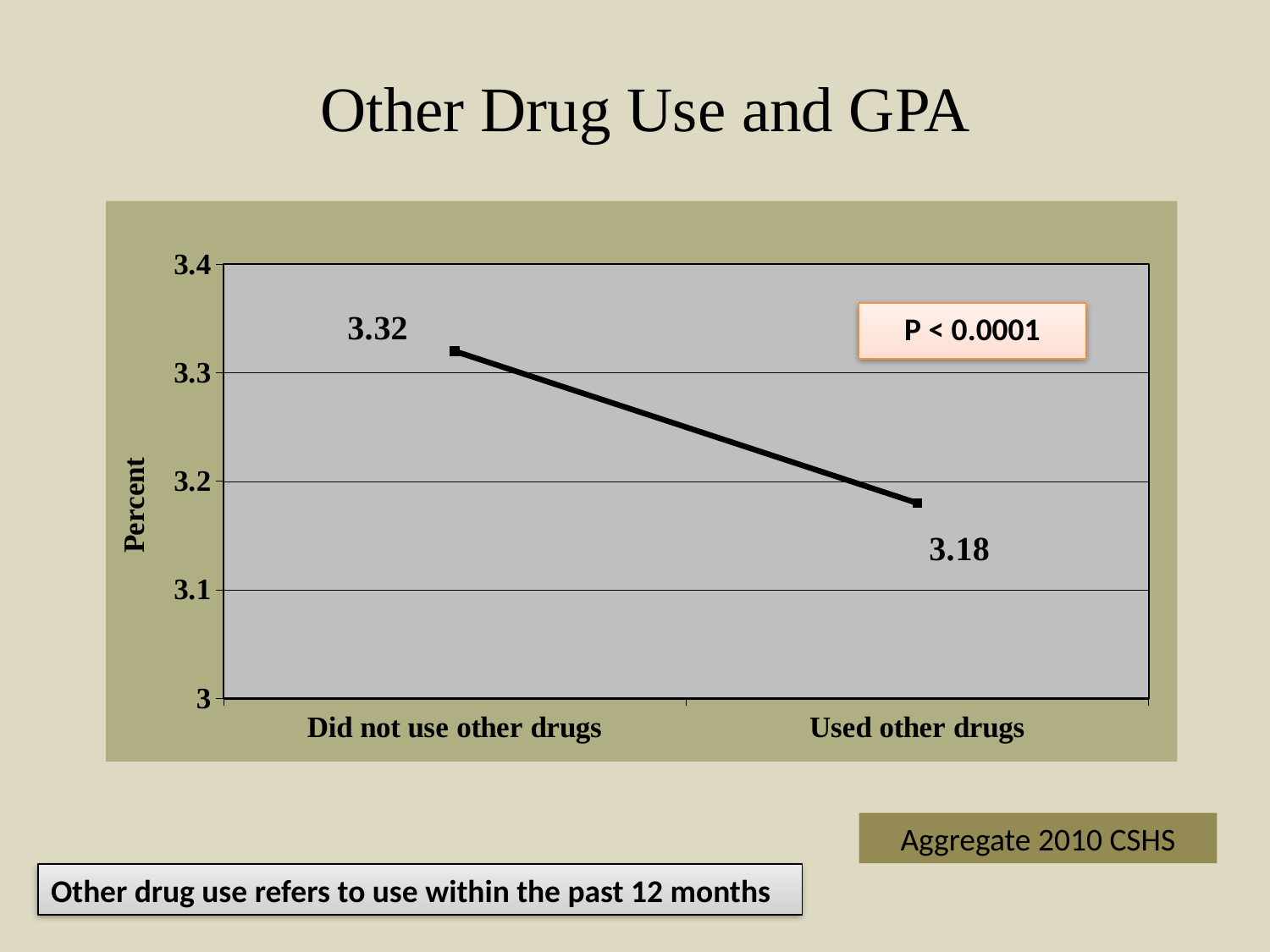
What kind of chart is shown on the slide? line chart How many categories are shown on the x axis? 2 Do the values rise or fall from "Did not use other drugs" to "Used other drugs"? fall What is the title of the slide's chart? Other Drug Use and GPA Is the value for "Did not use other drugs" greater or less than 3.3? greater Which category has the highest value? Did not use other drugs What is the difference between the values for "Did not use other drugs" and "Used other drugs"? 0.14 Which is larger, the value for "Did not use other drugs" or the value for "Used other drugs"? Did not use other drugs What is the value for "Used other drugs"? 3.18 What is the value for "Did not use other drugs"? 3.32 Is the value for "Used other drugs" greater or less than 3.2? less Which category has the lowest value? Used other drugs